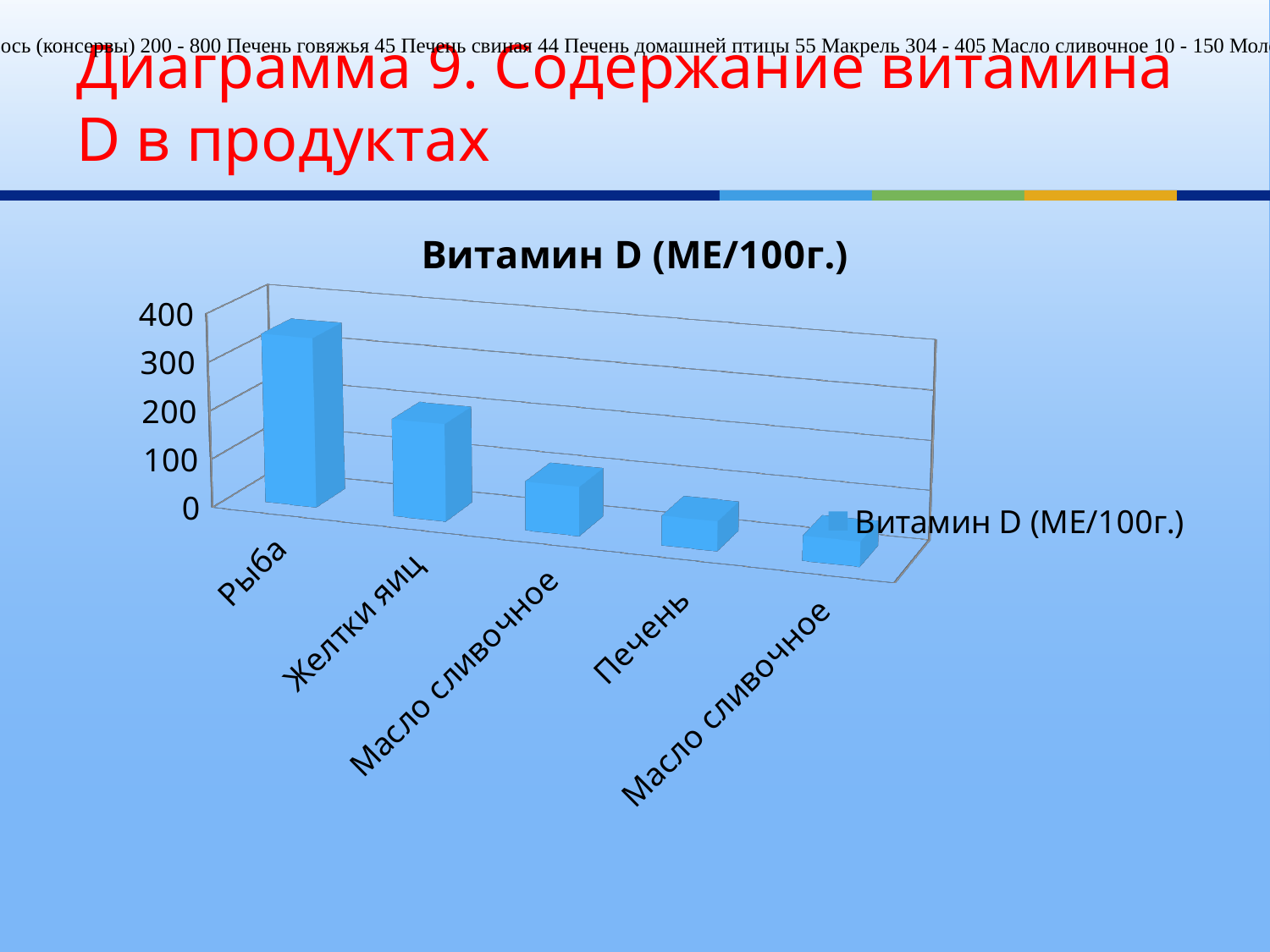
Is the value for Желтки яиц greater or less than 100? greater Which has a larger value, Рыба or Желтки яиц? Рыба What kind of chart is shown on the slide? bar chart Which category has the highest value in the chart? Рыба What is the title of the chart? Витамин D (МЕ/100г.) Which bar is the lowest in the chart? the last bar (Масло сливочное, fifth category) Do the bar values rise or fall from left to right along the x axis? fall How many categories are plotted on the x axis of the chart? 5 Is the value for Рыба greater or less than 200? greater How many series does the chart legend list? 1 Is the value for Печень greater or less than 100? less Which has a larger value, Желтки яиц or Печень? Желтки яиц